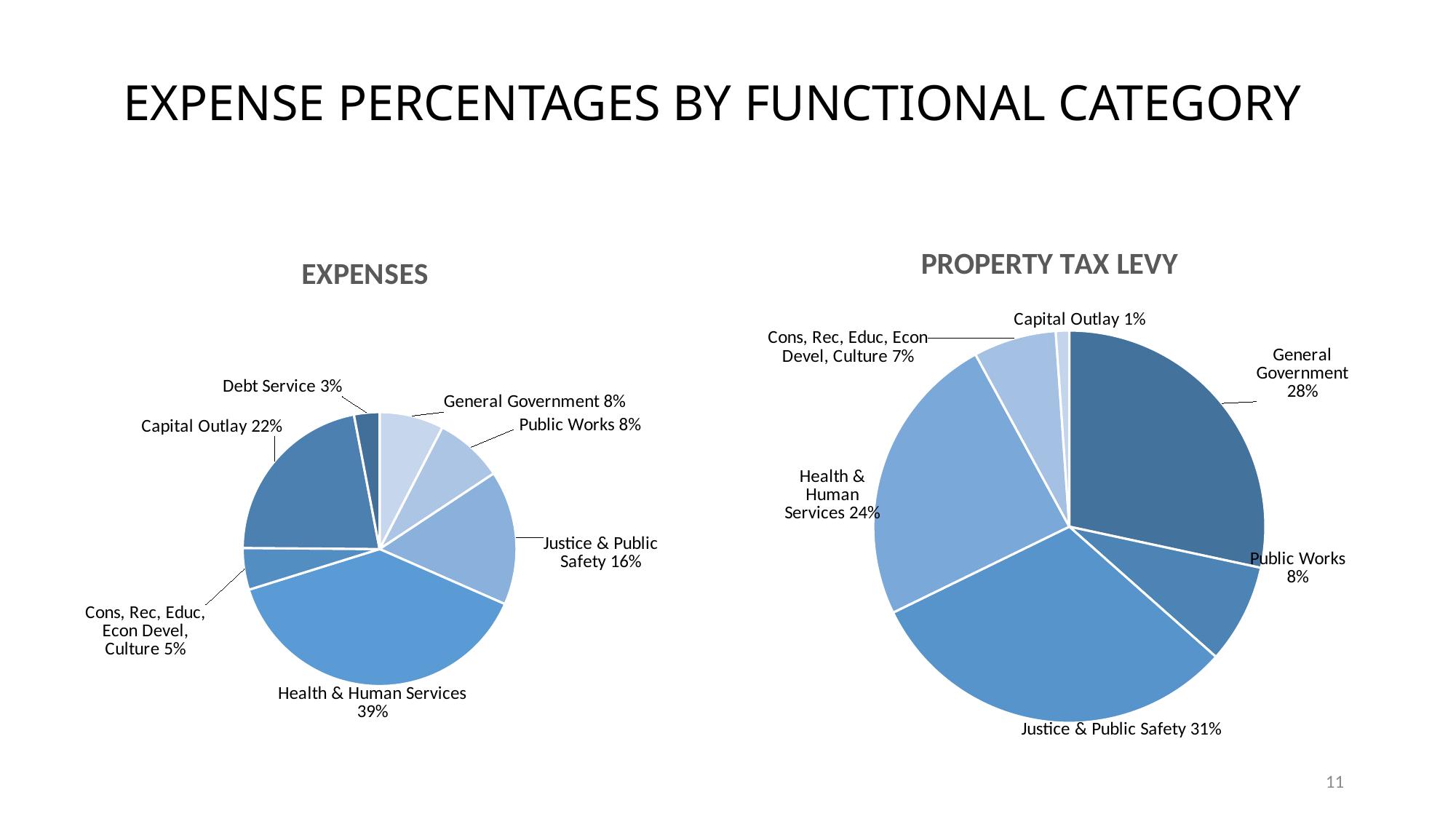
In the PROPERTY TAX LEVY chart, which category has the smallest share? Capital Outlay In the PROPERTY TAX LEVY chart, what percentage is General Government? 28% How many categories are shown in the EXPENSES chart? 7 In the EXPENSES chart, what percentage is Capital Outlay? 22% In the EXPENSES chart, which category has the largest share? Health & Human Services In the EXPENSES chart, what percentage is Health & Human Services? 39% What kind of chart is the PROPERTY TAX LEVY chart? Pie chart In the EXPENSES chart, what is the difference in percentage points between Health & Human Services and Capital Outlay? 17 In the EXPENSES chart, which category has the smallest share? Debt Service In the PROPERTY TAX LEVY chart, which is larger: Health & Human Services or General Government? General Government In the PROPERTY TAX LEVY chart, what percentage is Justice & Public Safety? 31% In the PROPERTY TAX LEVY chart, which category has the largest share? Justice & Public Safety